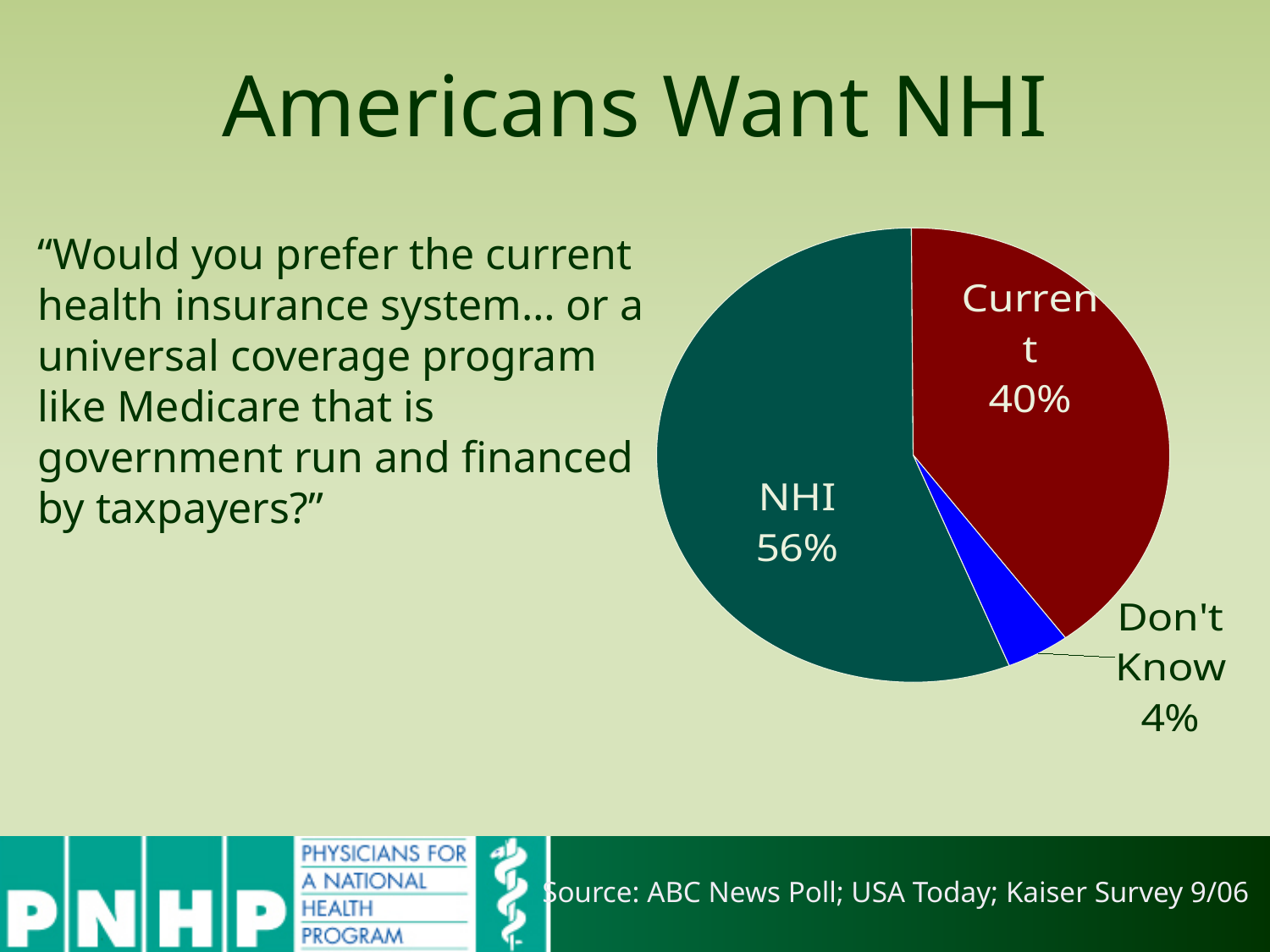
What is the combined share of NHI and Current? 96% What colour is the NHI slice? dark teal green Which slice of the pie is the largest? NHI What share of respondents answered Don't Know? 4% What kind of chart is shown on the slide? pie chart What is the difference in percentage points between NHI and Current? 16 What share of respondents preferred NHI? 56% What share of respondents preferred the Current system? 40% How many slices does the pie chart have? 3 Which slice of the pie is the smallest? Don't Know Which is larger, the share for Current or the share for Don't Know? Current What is the title of the slide containing the pie chart? Americans Want NHI